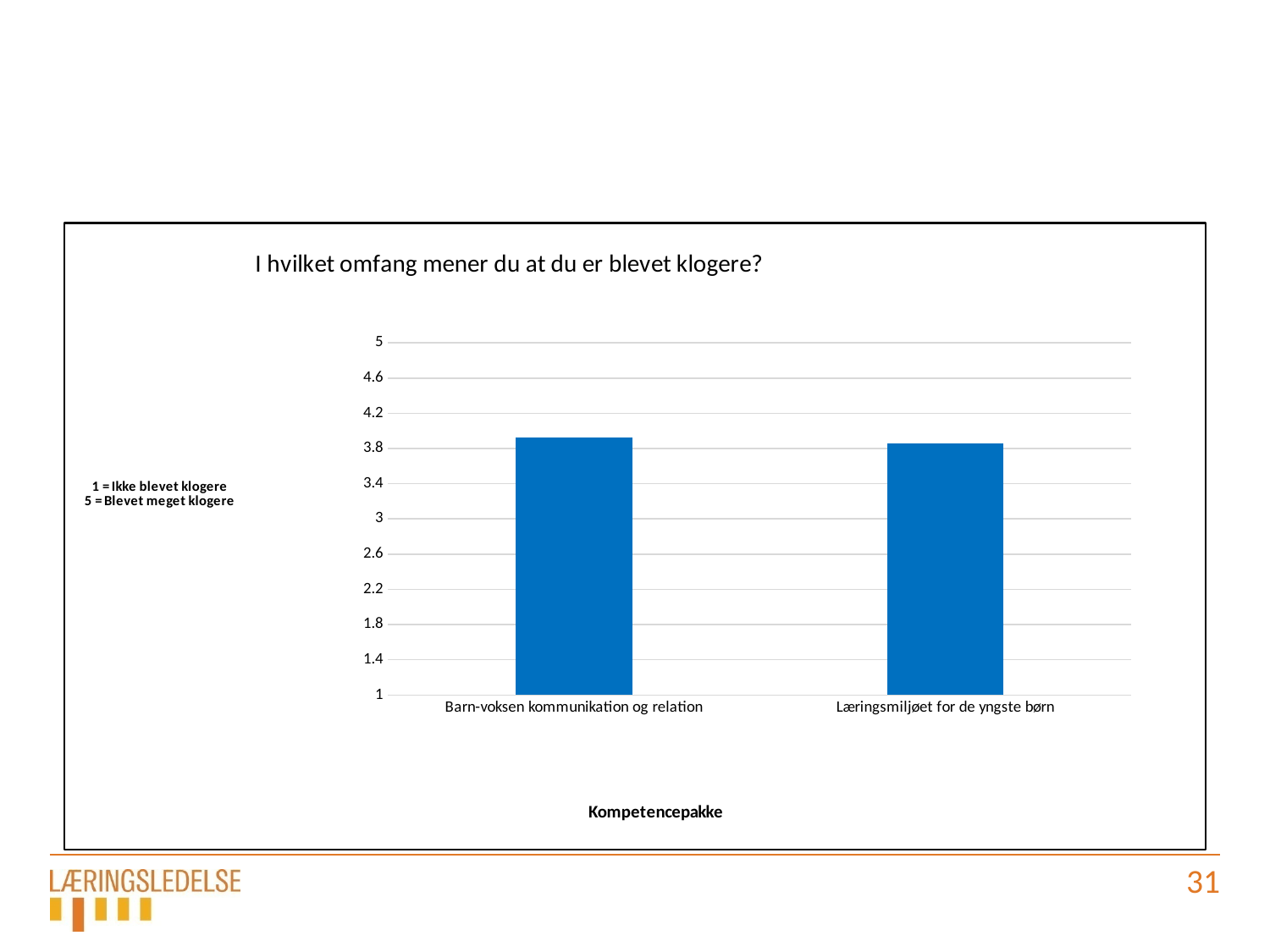
What kind of chart is shown on the slide? bar chart Is the value for Barn-voksen kommunikation og relation greater or less than 3.4? greater What is the label of the x axis? Kompetencepakke What is the highest value shown on the y axis? 5 Is the value for Barn-voksen kommunikation og relation greater or less than 4.2? less Is the value for Læringsmiljøet for de yngste børn greater or less than 3? greater What is the title of the chart? I hvilket omfang mener du at du er blevet klogere? How many categories are plotted on the x axis? 2